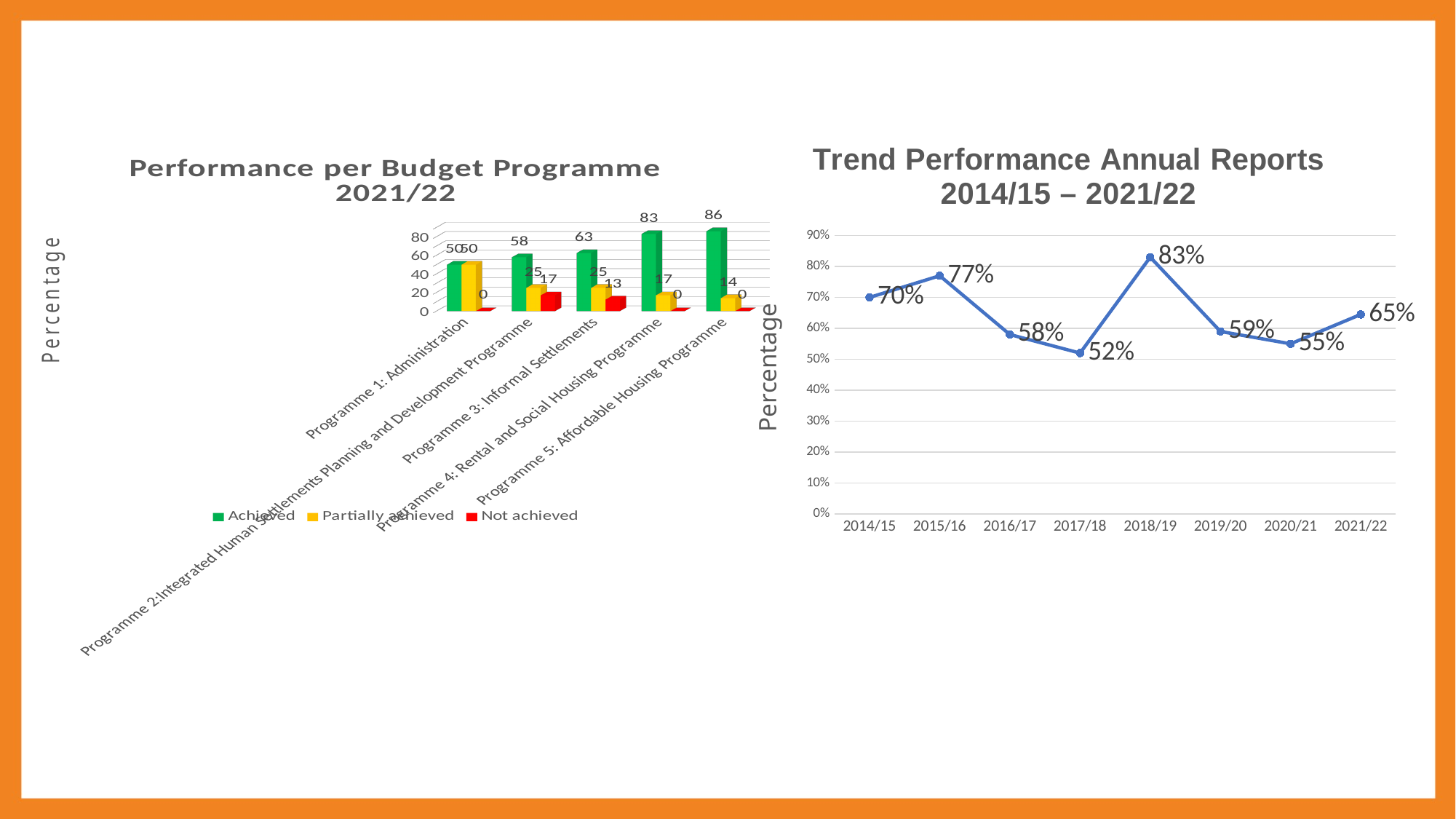
In the 'Performance per Budget Programme 2021/22' chart, what is the Achieved value for Programme 5: Affordable Housing Programme? 86 In the 'Trend Performance Annual Reports 2014/15 – 2021/22' chart, what is the difference between the 2015/16 and 2016/17 values? 19% In the 'Performance per Budget Programme 2021/22' chart, which programme has the highest Achieved value? Programme 5: Affordable Housing Programme What kind of chart is 'Trend Performance Annual Reports 2014/15 – 2021/22'? line chart In the 'Trend Performance Annual Reports 2014/15 – 2021/22' chart, how many years are plotted? 8 In the 'Trend Performance Annual Reports 2014/15 – 2021/22' chart, does the value rise or fall from 2020/21 to 2021/22? rise In the 'Performance per Budget Programme 2021/22' chart, is the Achieved value for Programme 3: Informal Settlements larger than the Achieved value for Programme 1: Administration? Yes In the 'Trend Performance Annual Reports 2014/15 – 2021/22' chart, what is the value for 2018/19? 83% In the 'Performance per Budget Programme 2021/22' chart, how many series does the legend list? 3 In the 'Trend Performance Annual Reports 2014/15 – 2021/22' chart, which year has the lowest value? 2017/18 In the 'Performance per Budget Programme 2021/22' chart, what colour represents the Not achieved series? Red In the 'Performance per Budget Programme 2021/22' chart, what is the Not achieved value for Programme 2? 17